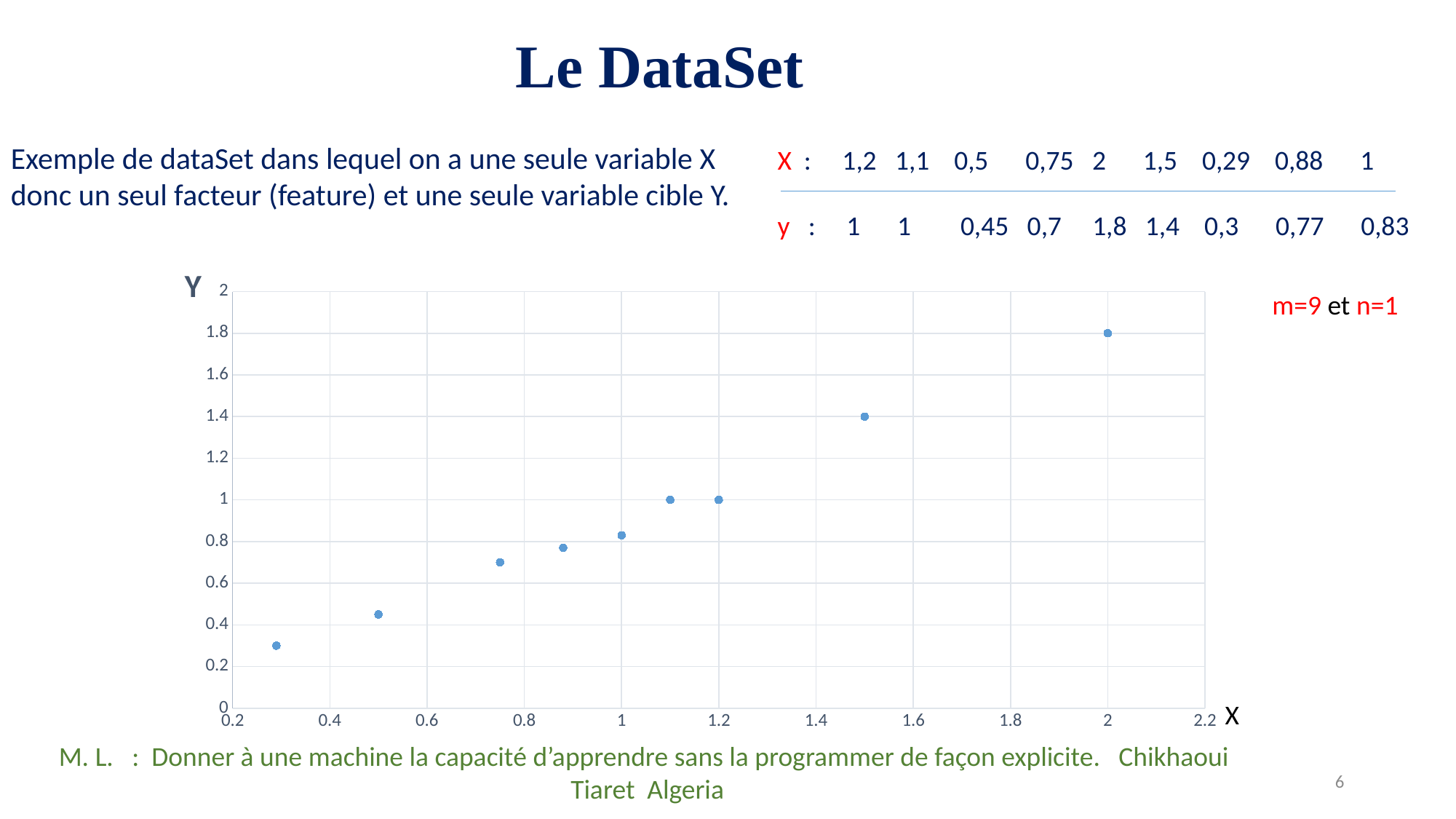
What is the Y value of the point at X = 2? 1.8 Which point has the larger Y value: the one at X = 1.5 or the one at X = 1? X = 1.5 What is the Y value of the point at X = 1.5? 1.4 What kind of chart is shown on the slide? scatter chart What is the difference between the Y value at X = 2 and the Y value at X = 1.5? 0.4 Is the Y value of the point at X = 0.5 greater or less than 0.6? less Do the Y values generally rise or fall as X increases? rise At which X value does the chart have its lowest Y value? 0.29 Is the Y value of the point at X = 0.75 greater or less than 0.6? greater How many data points are plotted on the chart? 9 What are the labels of the horizontal and vertical axes of the chart? X and Y At which X value does the chart reach its highest Y value? 2